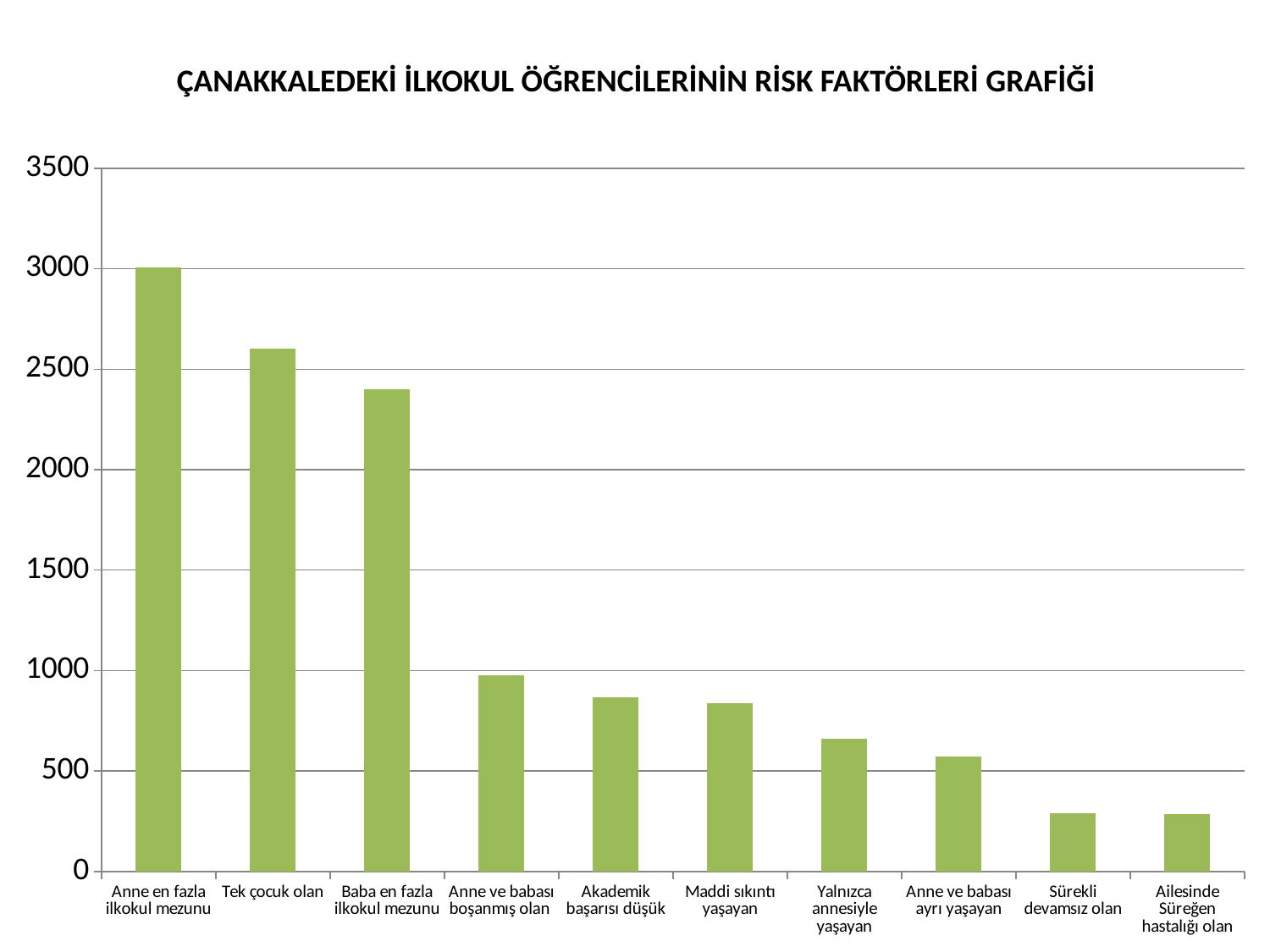
Is the value for Anne ve babası boşanmış olan greater or less than 1000? less Is the value for Akademik başarısı düşük greater or less than 500? greater Which is larger, the value for Tek çocuk olan or the value for Baba en fazla ilkokul mezunu? Tek çocuk olan Is the value for Yalnızca annesiyle yaşayan greater or less than 1000? less How many categories are plotted on the chart? 10 Which category has the highest value? Anne en fazla ilkokul mezunu What kind of chart is shown on the slide? bar chart Do the values rise or fall from left to right along the x axis? fall What is the title of the chart? ÇANAKKALEDEKİ İLKOKUL ÖĞRENCİLERİNİN RİSK FAKTÖRLERİ GRAFİĞİ